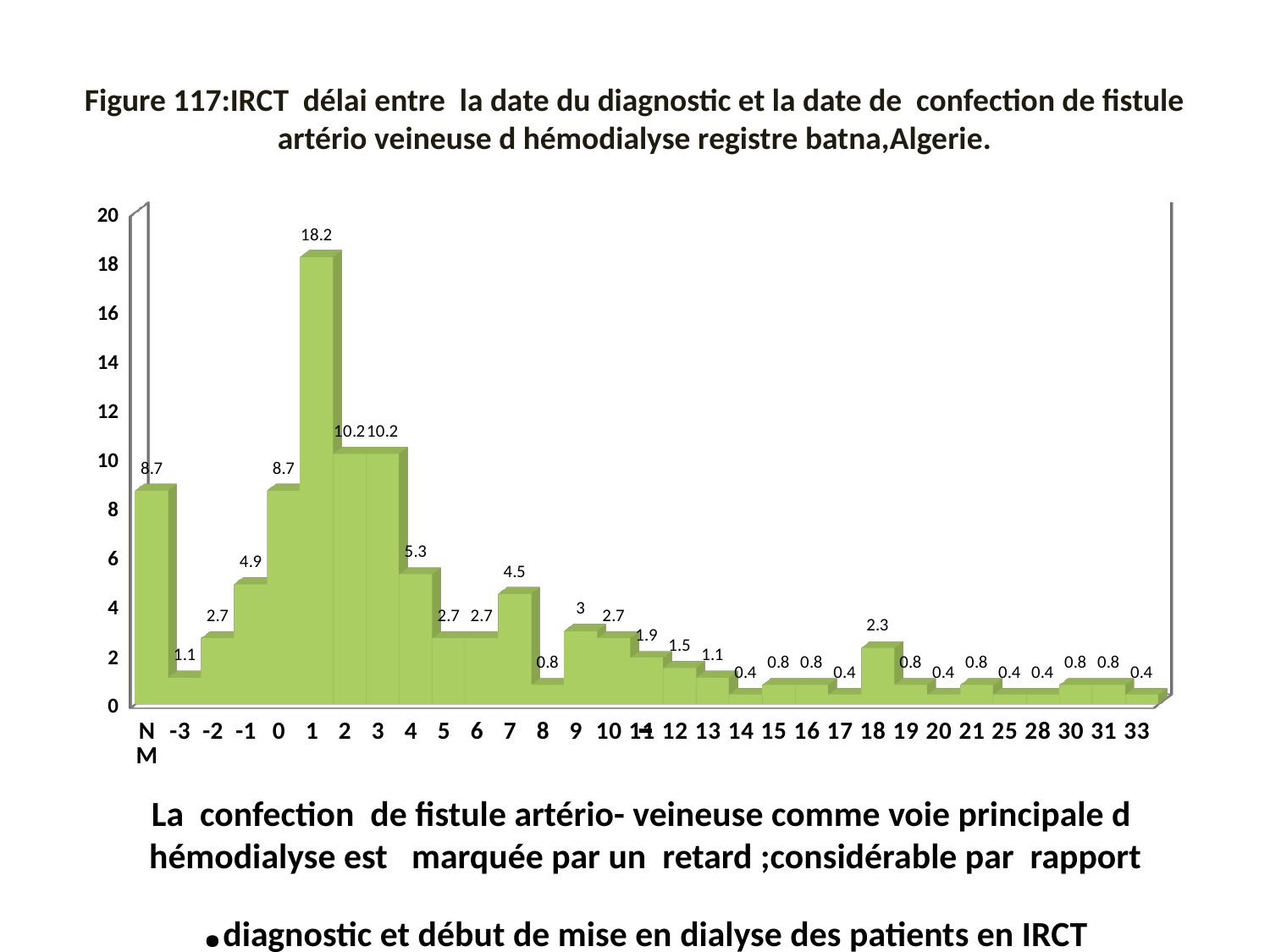
What is the value for category 1? 18.2 What is the value for category NM? 8.7 What is the difference between the values for category 1 and category 2? 8 Is the value for category 0 greater or less than 8? greater What kind of chart is shown on the slide? bar chart What is the value for category 7? 4.5 What colour are the bars in the chart? green What is the value for category 18? 2.3 Which category has the highest value? 1 Do the values rise or fall from category 1 to category 8? fall Which is larger, the value for category -1 or the value for category 4? 4 What is the difference between the values for category 0 and category -1? 3.8